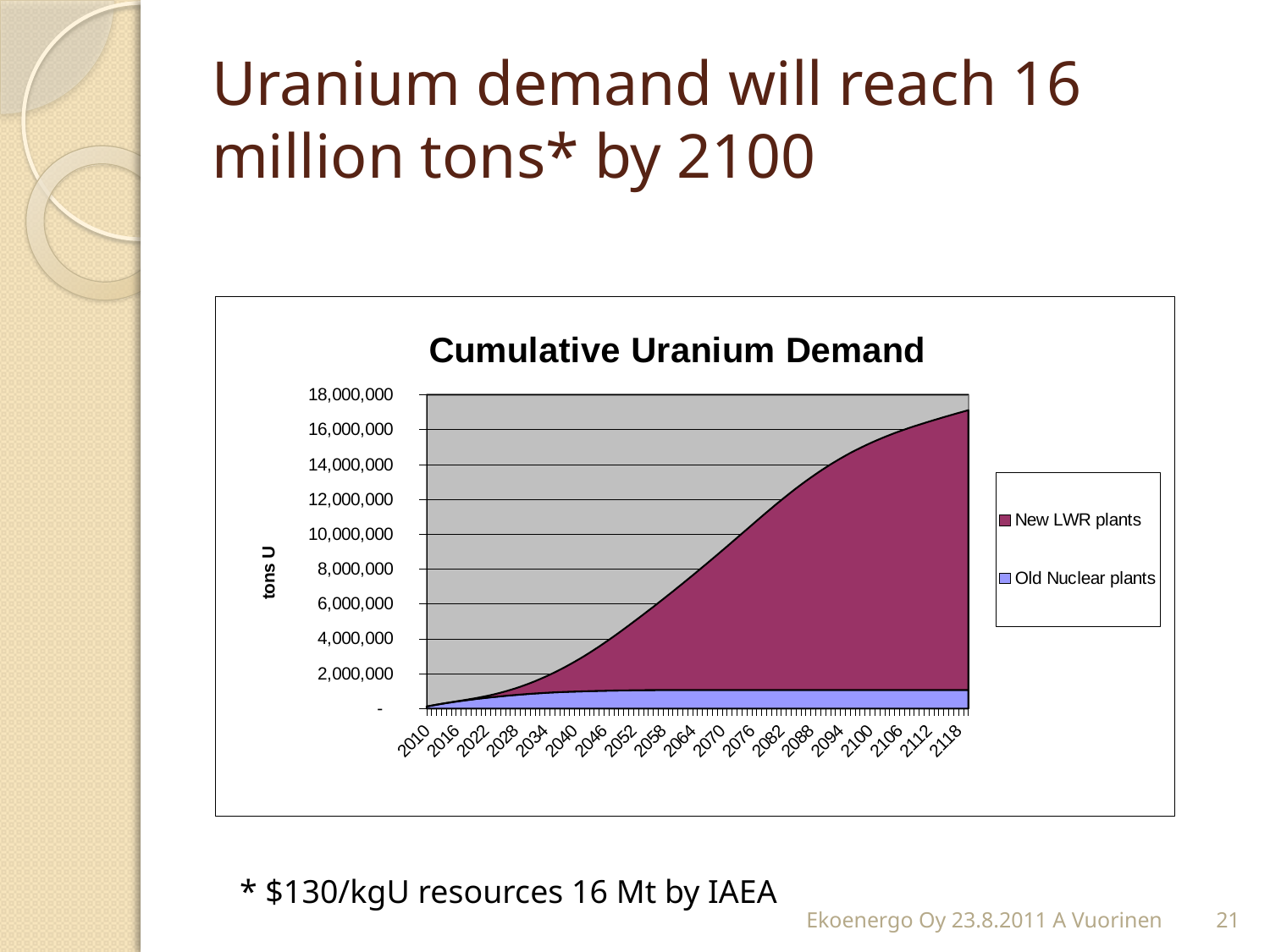
Does the cumulative uranium demand rise or fall from 2010 to 2118? Rise Is the total cumulative demand in 2100 greater or less than 14,000,000 tons U? greater Which series is shown in the dark red/magenta colour? New LWR plants What type of chart is shown on the slide? Stacked area chart Which series contributes more to the cumulative demand in 2100, New LWR plants or Old Nuclear plants? New LWR plants Is the cumulative demand from Old Nuclear plants in 2118 greater or less than 2,000,000 tons U? less Is the total cumulative demand in 2040 greater or less than 4,000,000 tons U? less What is the label of the y axis? tons U What is the highest value shown on the y axis? 18,000,000 How many series does the legend list? 2